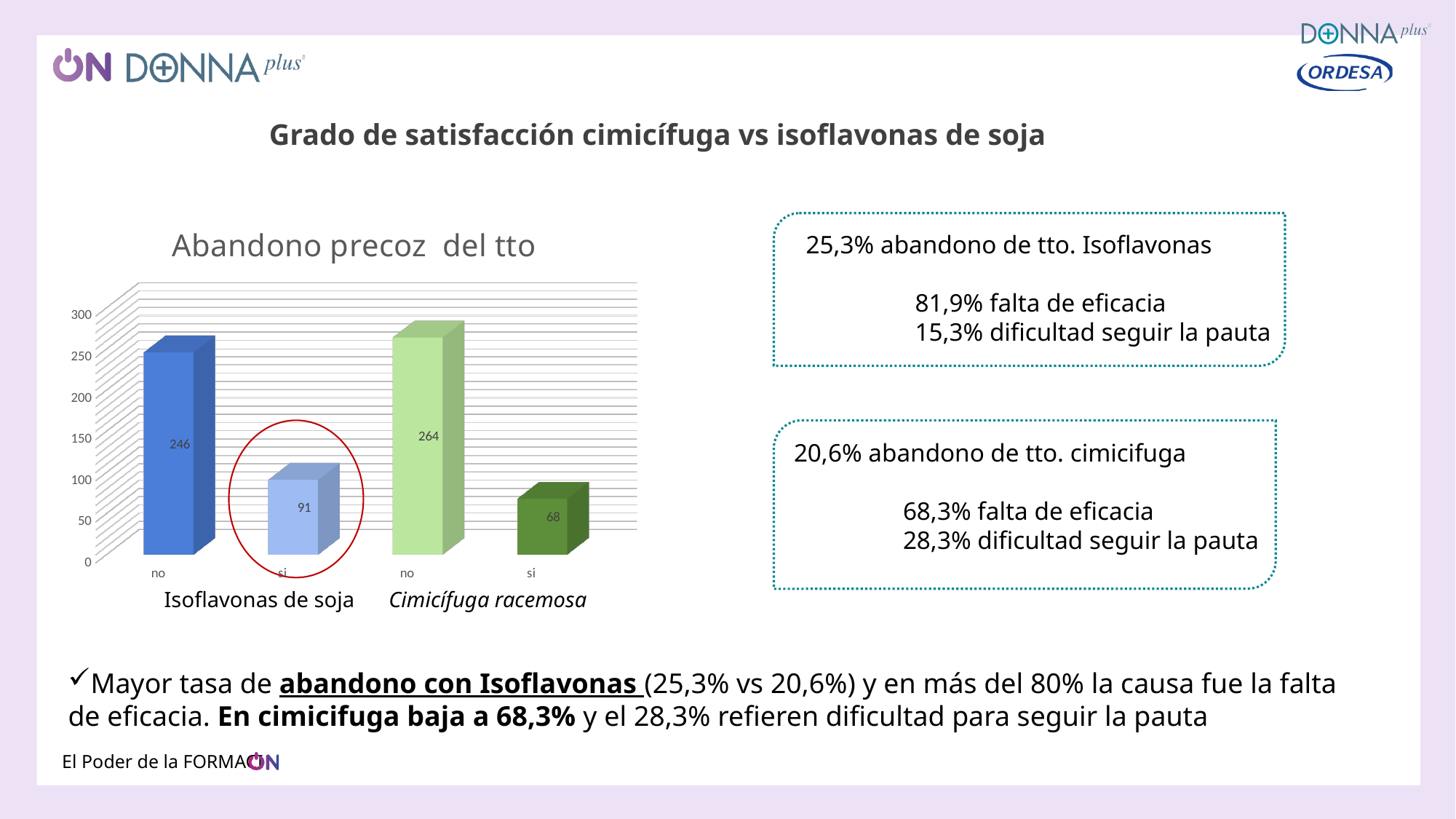
What is the title of the chart? Abandono precoz del tto Which is larger: the 'si' bar for Isoflavonas de soja or the 'si' bar for Cimicífuga racemosa? Isoflavonas de soja How many bars are plotted in the chart? 4 What type of chart is shown on the slide? Bar chart What is the value of the 'no' bar for Cimicífuga racemosa? 264 What is the value of the 'si' bar for Cimicífuga racemosa? 68 Which bar has the lowest value in the chart? Cimicífuga racemosa, si What is the difference between the 'no' bars for Cimicífuga racemosa and Isoflavonas de soja? 18 What is the value of the 'si' bar for Isoflavonas de soja? 91 Which bar has the highest value in the chart? Cimicífuga racemosa, no What is the value of the 'no' bar for Isoflavonas de soja in the 'Abandono precoz del tto' chart? 246 What is the difference between the 'si' bars for Isoflavonas de soja and Cimicífuga racemosa? 23